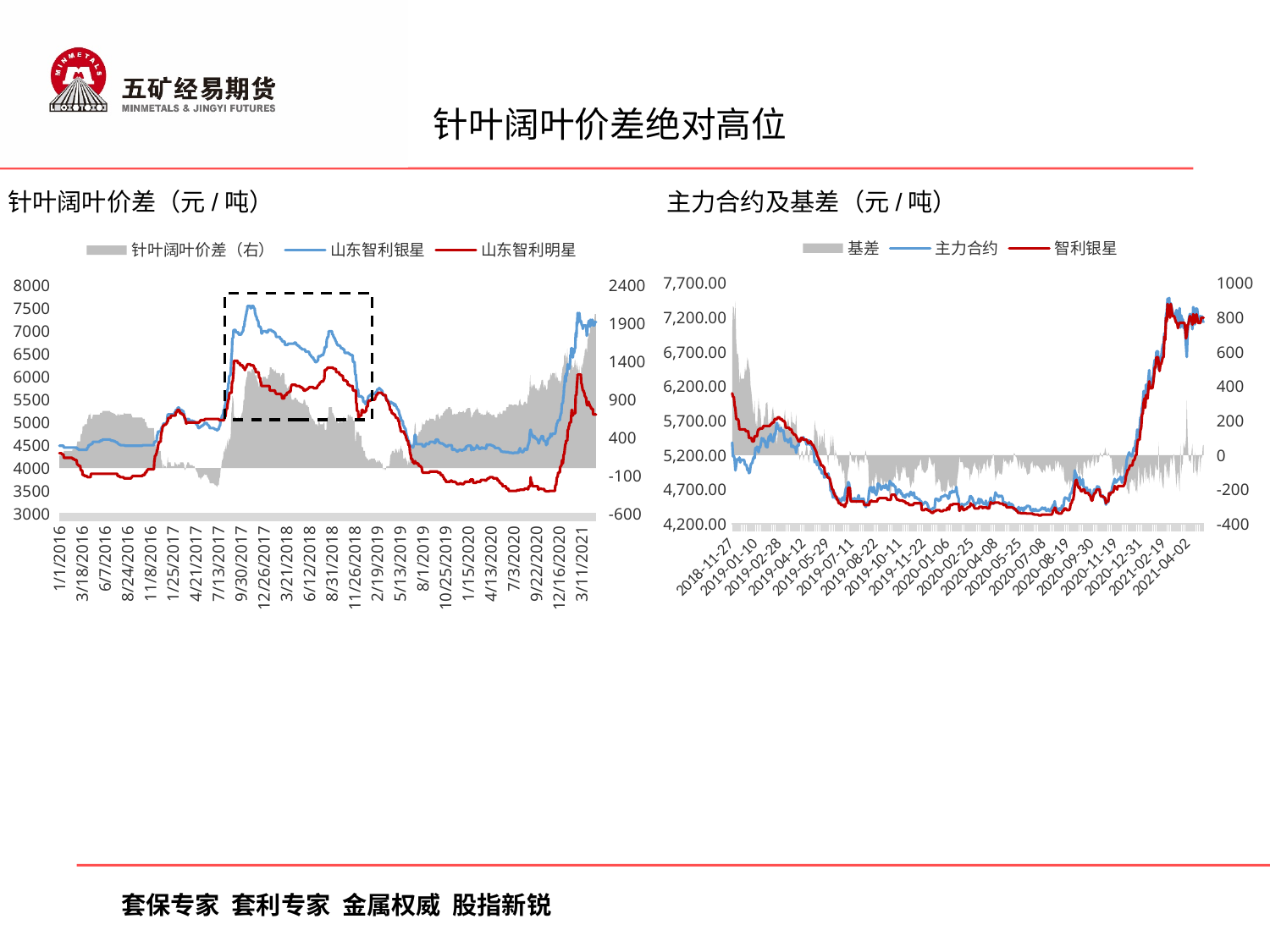
In the right chart (主力合约及基差), is the value of 智利银星 at 2018-11-27 greater or less than 5,700.00? greater In the left chart (针叶阔叶价差), does the 山东智利银星 line rise or fall between 9/30/2017 and 11/26/2018? fall In the left chart (针叶阔叶价差), around 9/30/2017, which series is higher: 山东智利银星 or 山东智利明星? 山东智利银星 What is the title of the right chart? 主力合约及基差（元 / 吨） What kind of chart is the left chart (针叶阔叶价差)? combination chart (lines with a shaded area series) In the left chart (针叶阔叶价差), is the value of 山东智利明星 around 9/22/2020 greater or less than 4000? less In the left chart (针叶阔叶价差), which series is plotted on the right-hand axis according to the legend? 针叶阔叶价差（右） In the right chart (主力合约及基差), does the 主力合约 line rise or fall between 2020-09-30 and 2021-02-19? rise How many series does the legend of the right chart (主力合约及基差) list? 3 How many series does the legend of the left chart (针叶阔叶价差) list? 3 In the right chart (主力合约及基差), is the value of 主力合约 around 2021-02-19 greater or less than 6,700.00? greater